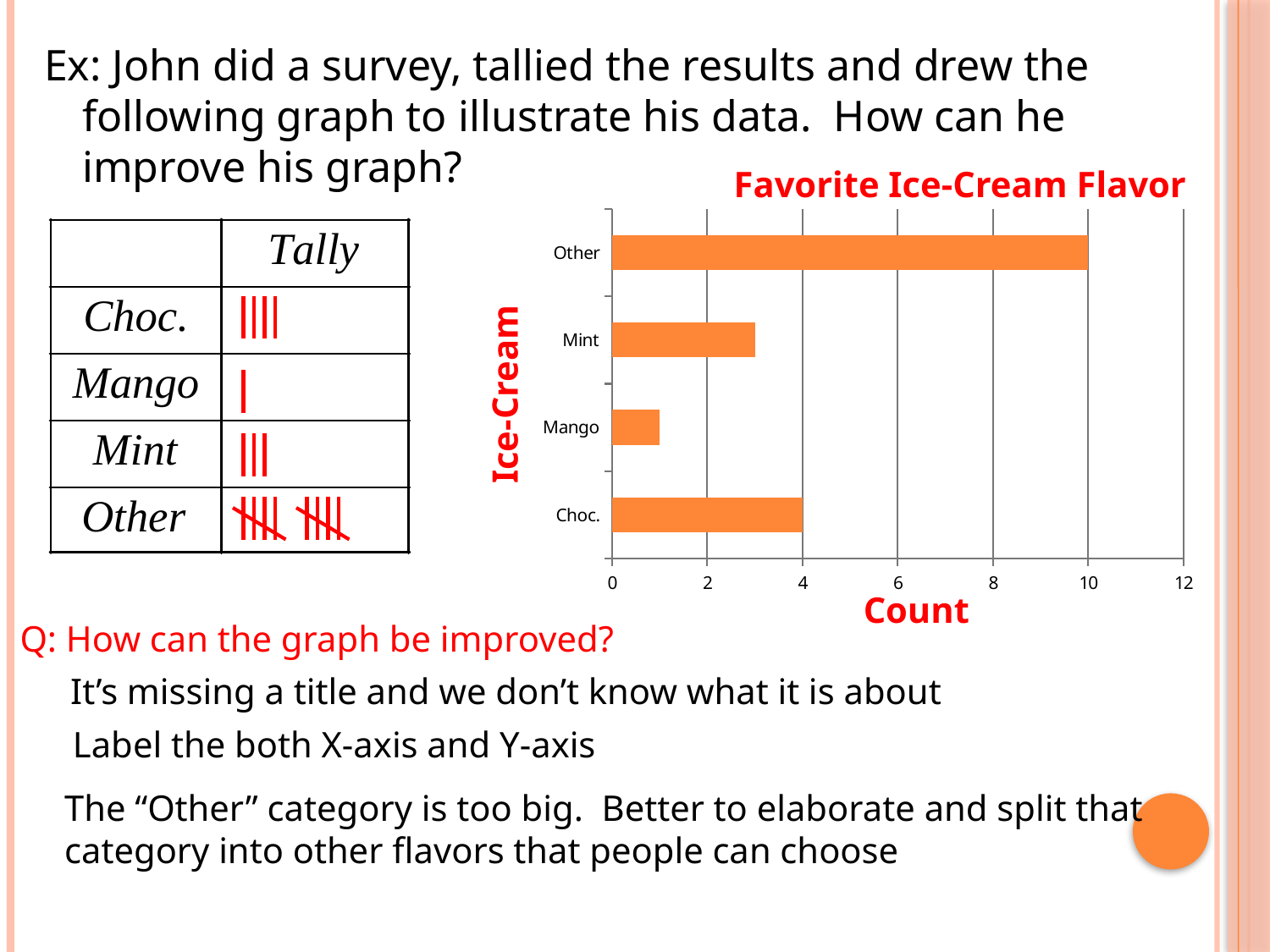
What is the label on the horizontal axis of the chart? Count Which ice-cream flavor has the lowest count in the chart? Mango What kind of chart is used to show the favorite ice-cream flavors? bar chart Which has a larger count, Mint or Choc.? Choc. Is the value for Mango greater or less than 2? less Is the value for Mint greater or less than 2? greater Which ice-cream flavor has the highest count in the chart? Other What is the value for Choc. in the Favorite Ice-Cream Flavor chart? 4 How many flavor categories are shown in the chart? 4 What is the difference between the counts for Other and Choc.? 6 What is the title of the chart? Favorite Ice-Cream Flavor What is the value for Other in the Favorite Ice-Cream Flavor chart? 10